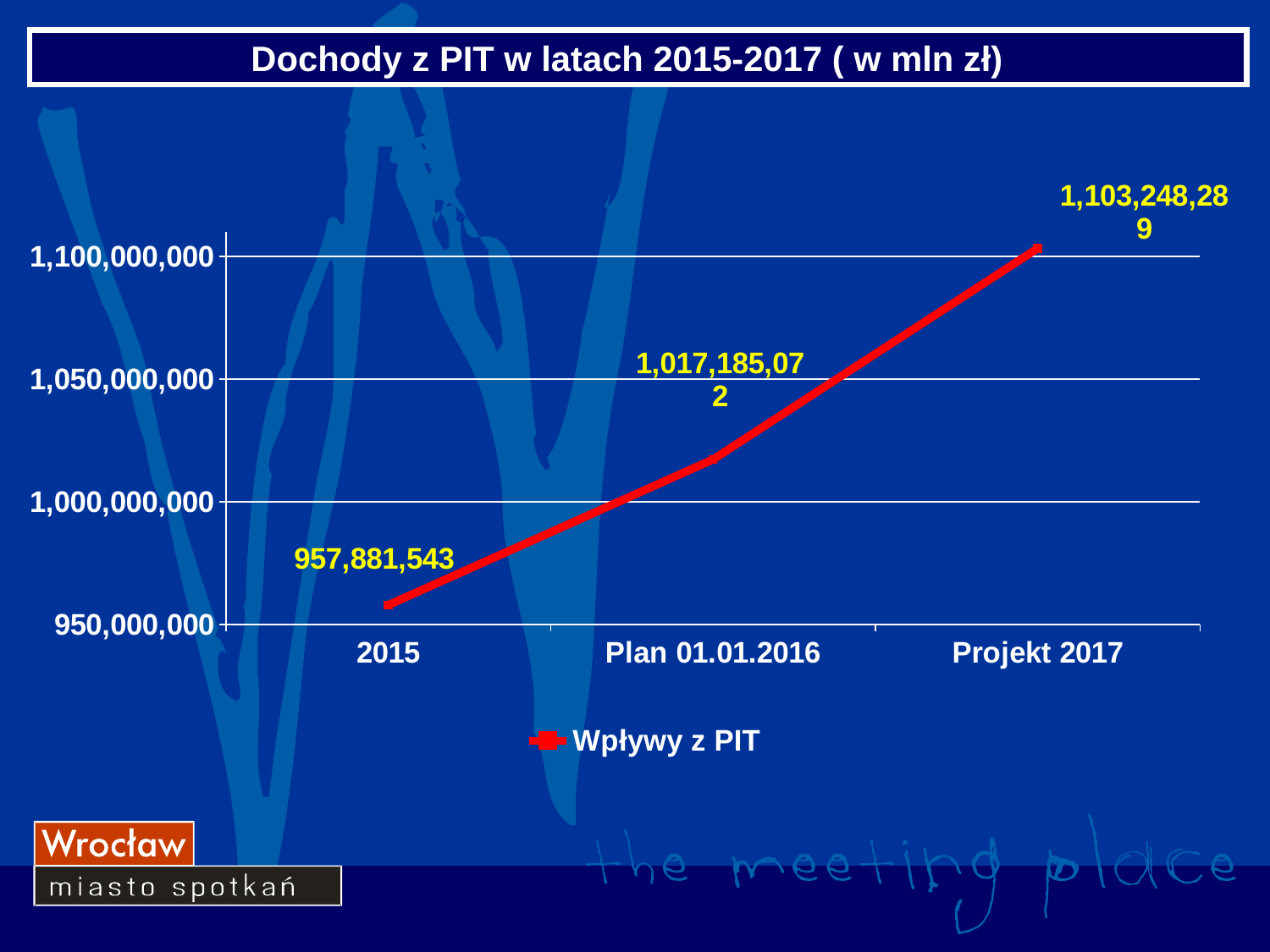
How many data points are plotted on the chart? 3 Which category has the highest value? Projekt 2017 What is the difference between the values for Plan 01.01.2016 and 2015? 59,303,529 Do the values rise or fall from 2015 to Projekt 2017? rise What is the value for Projekt 2017? 1,103,248,289 Is the value for 2015 greater or less than 1,000,000,000? less What kind of chart is shown on the slide? line chart What is the value for Plan 01.01.2016? 1,017,185,072 What is the value for 2015? 957,881,543 What is the difference between the values for Projekt 2017 and Plan 01.01.2016? 86,063,217 Which is larger, the value for Plan 01.01.2016 or the value for 2015? Plan 01.01.2016 Which category has the lowest value? 2015